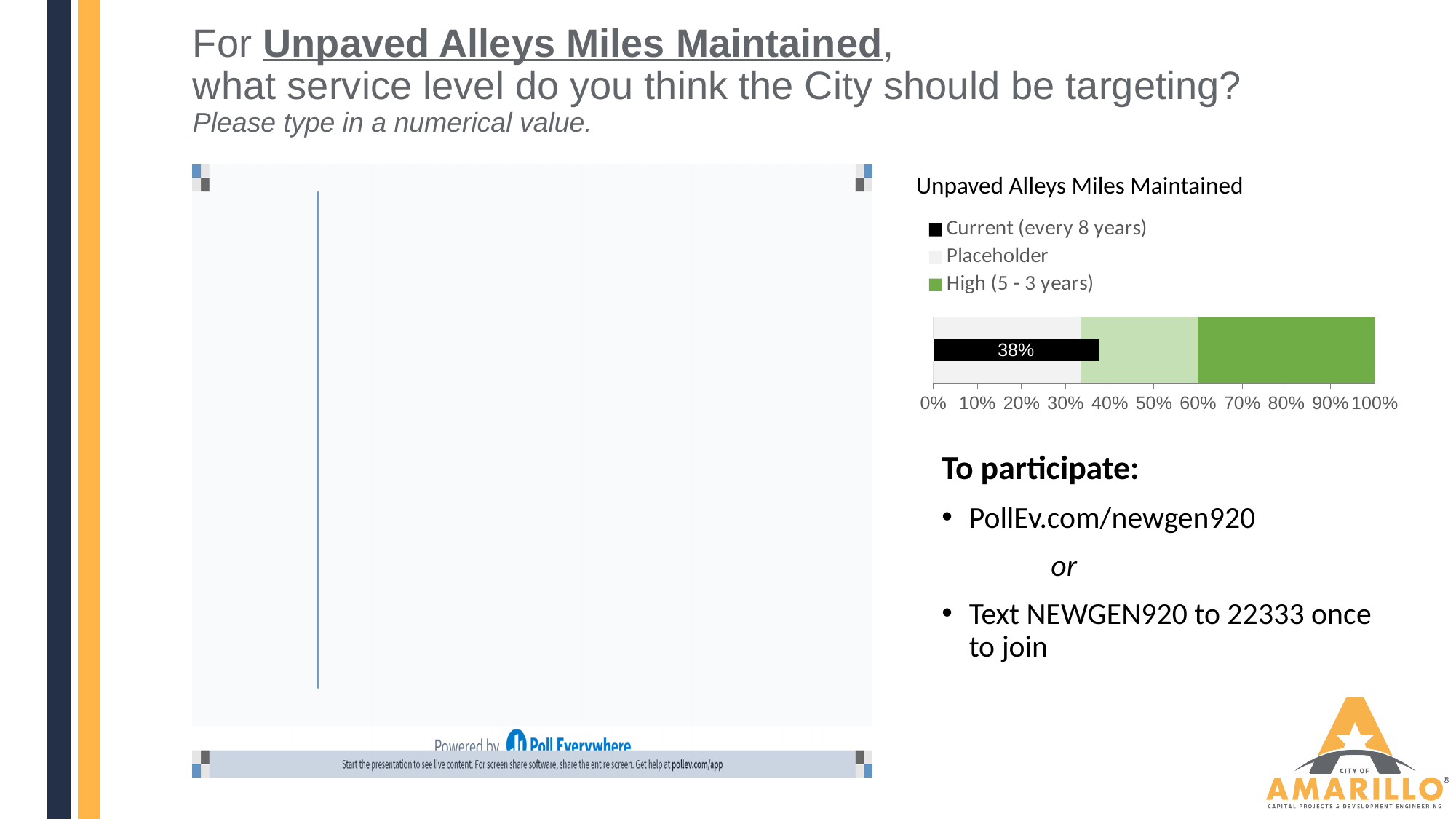
In the "Unpaved Alleys Miles Maintained" chart, what value is labelled on the Current (every 8 years) bar? 38% How many series does the legend of the "Unpaved Alleys Miles Maintained" chart list? 3 What type of chart is shown under the title "Unpaved Alleys Miles Maintained"? bar chart In the "Unpaved Alleys Miles Maintained" chart, is the Current (every 8 years) value greater or less than 30%? greater In the "Unpaved Alleys Miles Maintained" chart, which legend entry is shown in black? Current (every 8 years) What is the highest value shown on the x axis of the "Unpaved Alleys Miles Maintained" chart? 100% In the "Unpaved Alleys Miles Maintained" chart, is the Current (every 8 years) value greater or less than 50%? less What is the title of the chart on the right side of the slide? Unpaved Alleys Miles Maintained